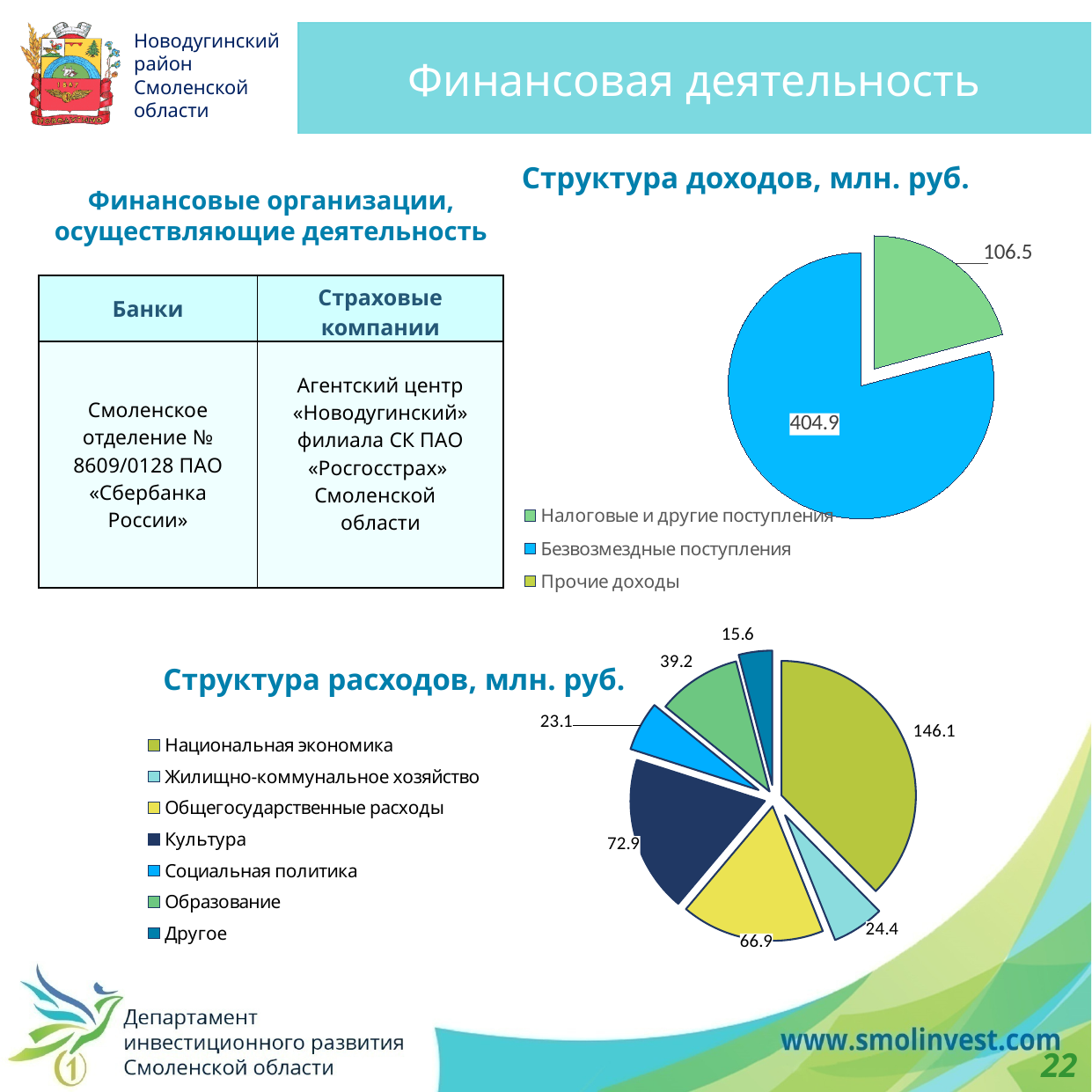
In the 'Структура доходов, млн. руб.' chart, what is the difference between Безвозмездные поступления and Налоговые и другие поступления? 298.4 In the 'Структура доходов, млн. руб.' chart, what is the value for Налоговые и другие поступления? 106.5 In the 'Структура доходов, млн. руб.' chart, what is the value for Безвозмездные поступления? 404.9 In the 'Структура расходов, млн. руб.' chart, which category has the smallest value? Другое What kind of chart is 'Структура расходов, млн. руб.'? pie chart In the 'Структура расходов, млн. руб.' chart, what is the value for Национальная экономика? 146.1 In the 'Структура расходов, млн. руб.' chart, what is the difference between Культура and Социальная политика? 49.8 In the 'Структура расходов, млн. руб.' chart, what is the value for Культура? 72.9 In the 'Структура расходов, млн. руб.' chart, which is larger: Общегосударственные расходы or Образование? Общегосударственные расходы In the 'Структура доходов, млн. руб.' chart, how many entries does the legend list? 3 In the 'Структура расходов, млн. руб.' chart, how many categories are shown? 7 In the 'Структура расходов, млн. руб.' chart, which category has the largest value? Национальная экономика